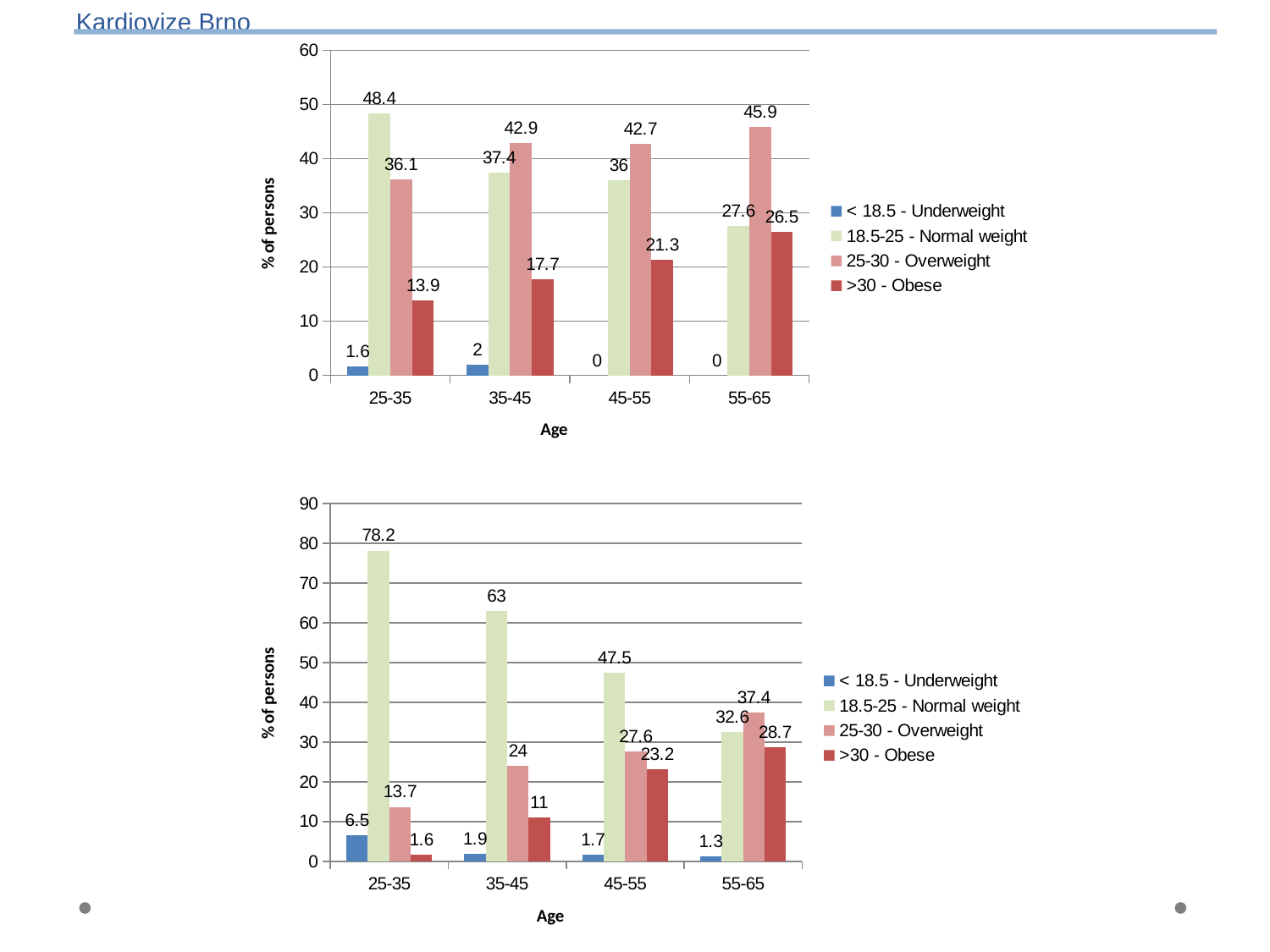
In the top chart, what is the value for >30 - Obese in the 25-35 age group? 13.9 In the bottom chart, how does the value for 18.5-25 - Normal weight change across the age groups from 25-35 to 55-65? It falls In the top chart, what is the difference between the 25-30 - Overweight and 18.5-25 - Normal weight values for the 35-45 age group? 5.5 In the bottom chart, what is the value for 18.5-25 - Normal weight in the 35-45 age group? 63 In the bottom chart, which age group has the lowest value for < 18.5 - Underweight? 55-65 In the top chart, how does the value for >30 - Obese change across the age groups from 25-35 to 55-65? It rises In the bottom chart, which is larger for the 55-65 age group: 25-30 - Overweight or 18.5-25 - Normal weight? 25-30 - Overweight In the top chart, which age group has the highest value for 18.5-25 - Normal weight? 25-35 What type of chart is the top chart? Bar chart In the top chart, what is the value for 25-30 - Overweight in the 55-65 age group? 45.9 How many series does the legend of the bottom chart list? 4 In the bottom chart, what is the difference between the 18.5-25 - Normal weight values for the 25-35 and 55-65 age groups? 45.6